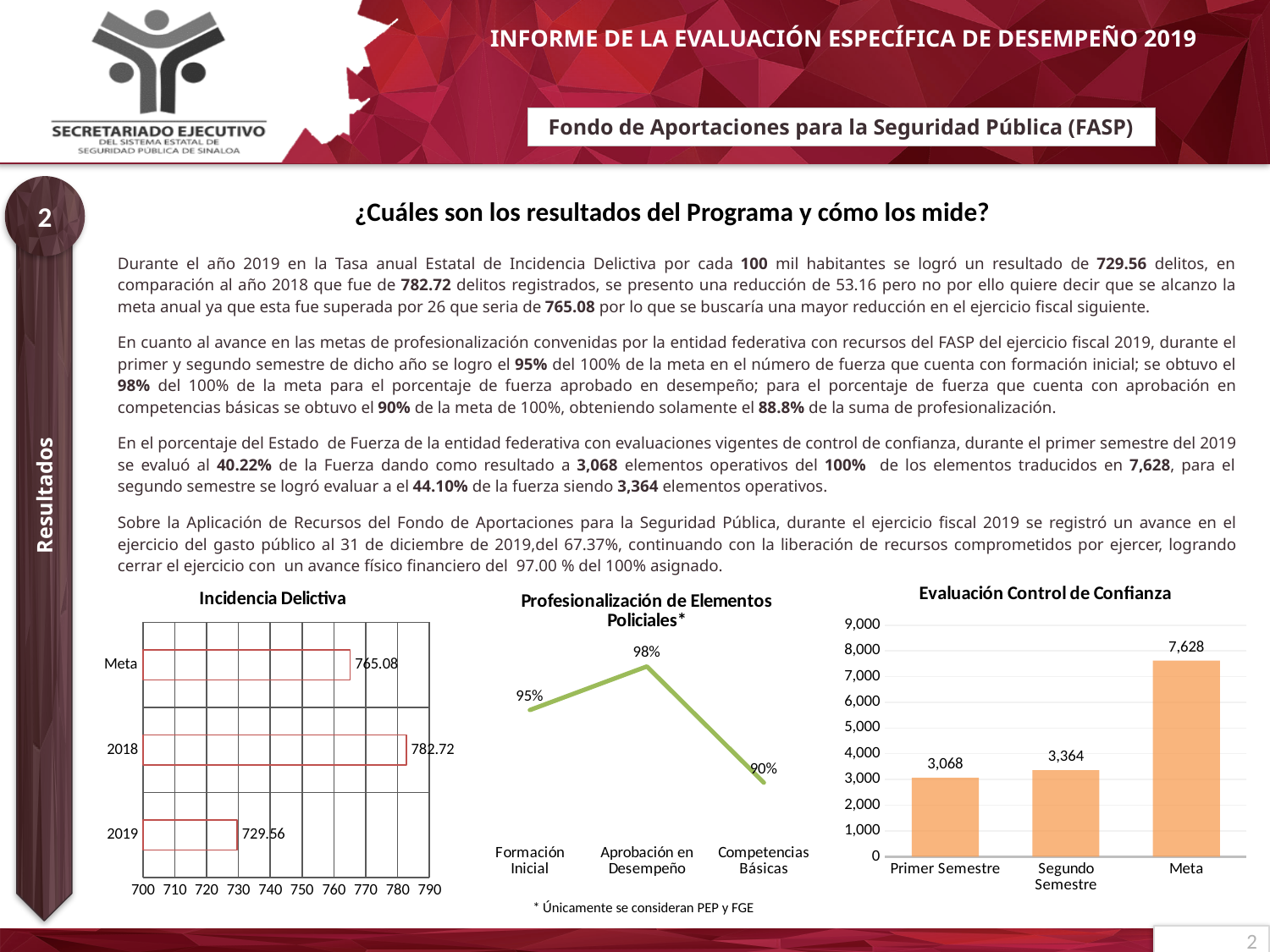
In the 'Evaluación Control de Confianza' chart, what is the value for Segundo Semestre? 3,364 What type of chart is the 'Profesionalización de Elementos Policiales*' chart? Line chart In the 'Incidencia Delictiva' chart, what is the value for 2019? 729.56 What type of chart is the 'Incidencia Delictiva' chart? Bar chart In the 'Incidencia Delictiva' chart, which category has the highest value? 2018 In the 'Profesionalización de Elementos Policiales*' chart, which category has the lowest value? Competencias Básicas In the 'Evaluación Control de Confianza' chart, which is larger, Primer Semestre or Segundo Semestre? Segundo Semestre In the 'Profesionalización de Elementos Policiales*' chart, what is the value for Aprobación en Desempeño? 98% In the 'Evaluación Control de Confianza' chart, is the value for Meta greater or less than 7,000? greater How many categories are shown in the 'Profesionalización de Elementos Policiales*' chart? 3 In the 'Incidencia Delictiva' chart, what is the difference between the 2018 value and the 2019 value? 53.16 In the 'Evaluación Control de Confianza' chart, what is the difference between Meta and Primer Semestre? 4,560